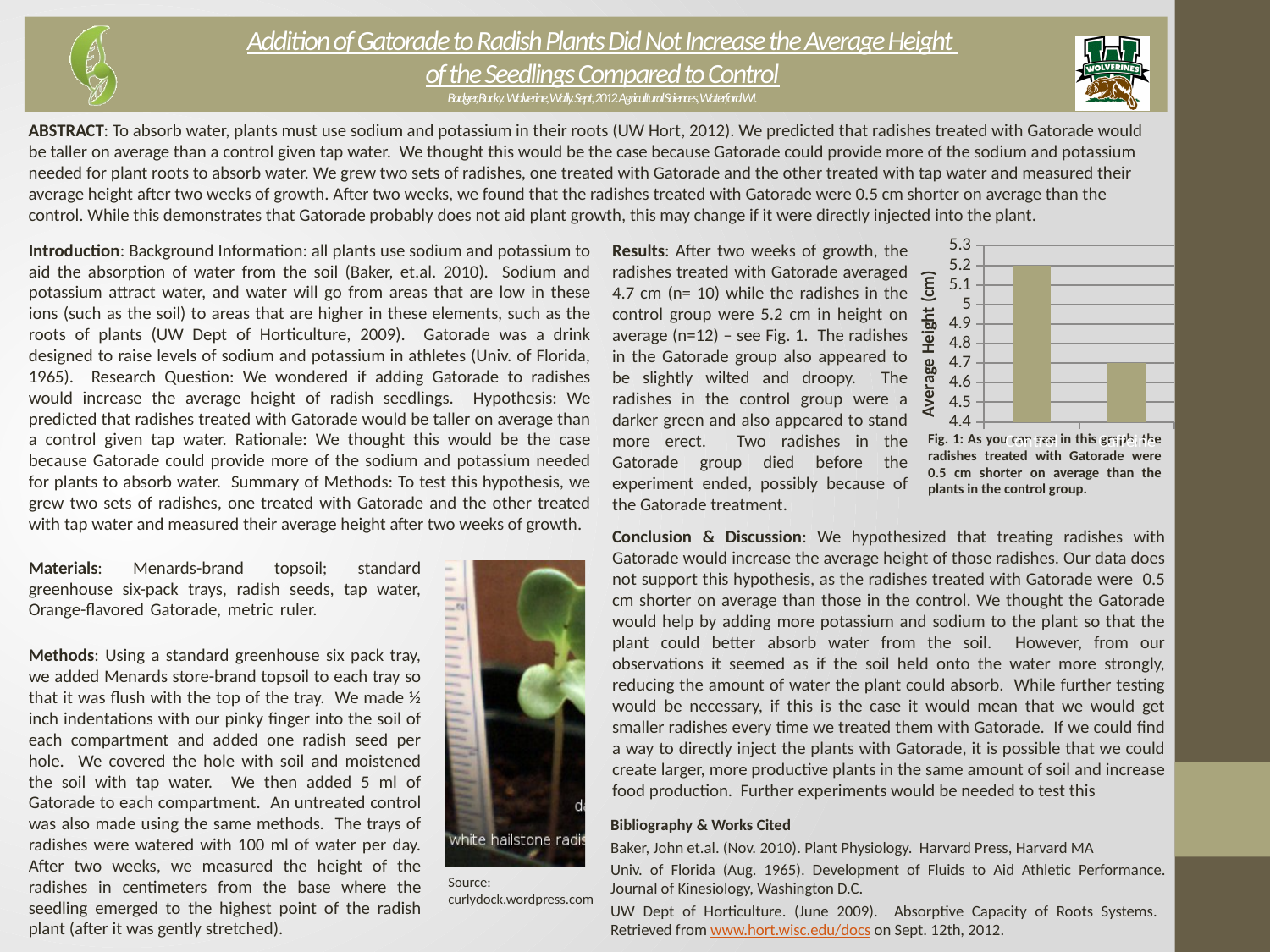
What value does the left bar in the chart reach on the vertical axis? 5.2 What is the title of the vertical axis of the chart? Average Height (cm) Is the value of the right bar in the chart greater or less than 5? less What is the highest value shown on the vertical axis of the chart? 5.3 What kind of chart is shown on the slide? bar chart How many bars are plotted in the chart? 2 Do the bar values rise or fall from left to right across the chart? fall Is the value of the left bar in the chart greater or less than 5? greater What value does the right bar in the chart reach on the vertical axis? 4.7 Which bar in the chart has the lowest value? the right bar Which bar is taller in the chart, the left bar or the right bar? the left bar What is the difference in height between the left bar and the right bar in the chart? 0.5